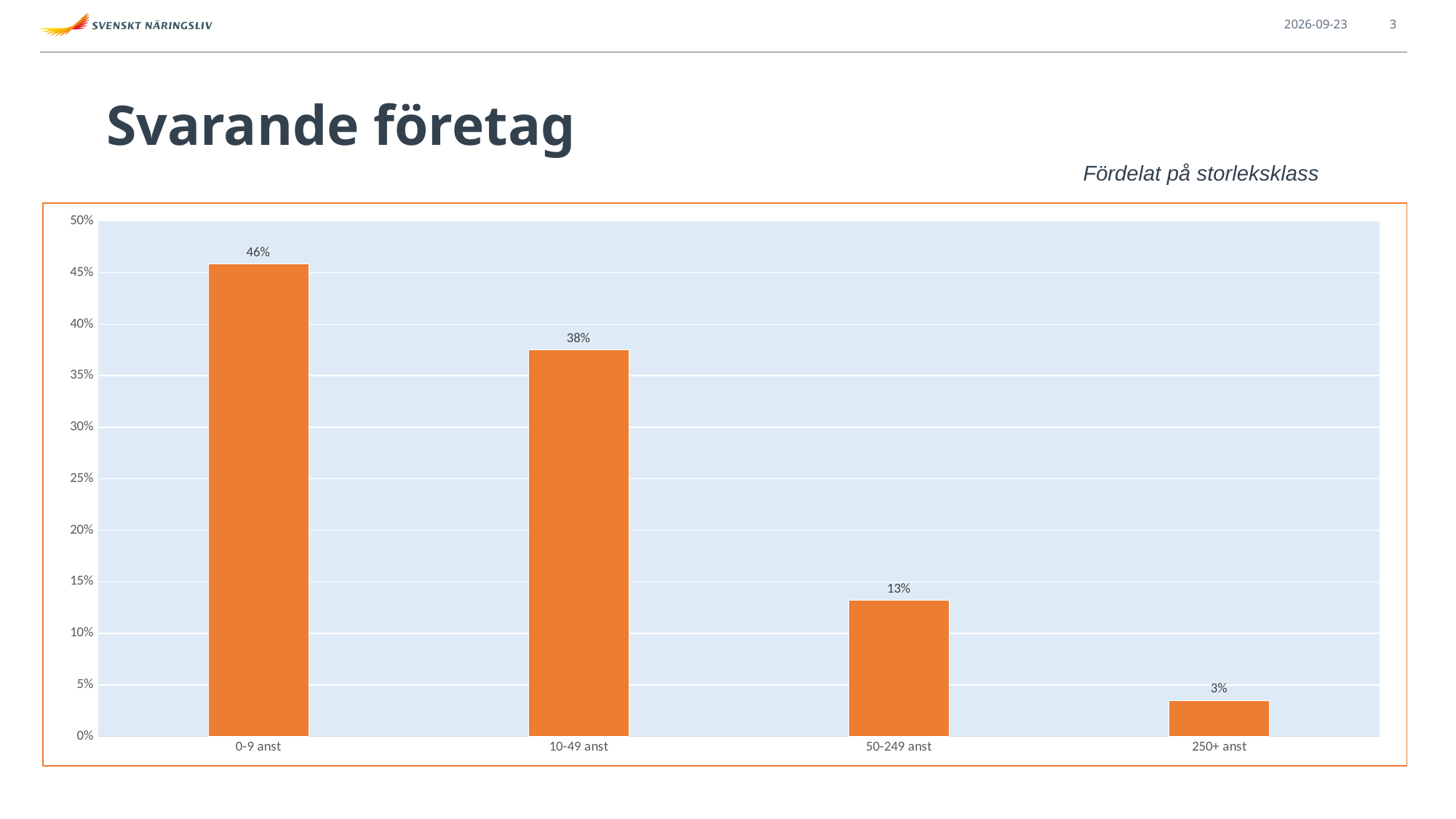
What kind of chart is shown on the slide? Bar chart How many size classes are shown on the x axis? 4 Do the values rise or fall from left to right along the x axis? Fall What is the value for 0-9 anst? 46% What is the value for 10-49 anst? 38% What is the value for 50-249 anst? 13% Which size class has the highest share of responding companies? 0-9 anst Which is larger, the value for 50-249 anst or the value for 250+ anst? 50-249 anst Is the value for 10-49 anst greater or less than 35%? greater What is the difference between the values for 0-9 anst and 10-49 anst? 8% Which size class has the lowest share of responding companies? 250+ anst What is the value for 250+ anst? 3%